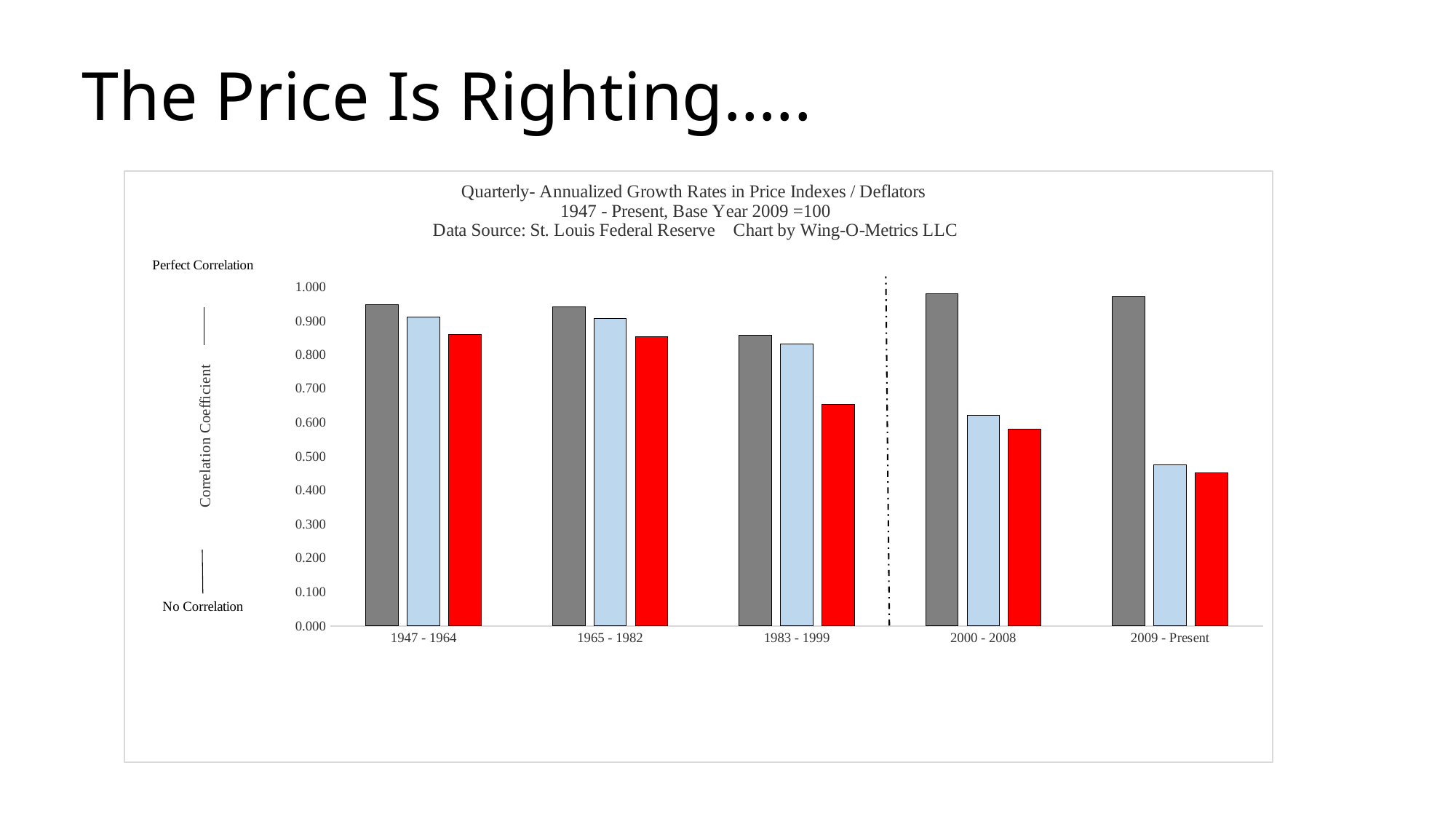
What is the label on the vertical axis? Correlation Coefficient Do the red bars generally rise or fall from 1947 - 1964 to 2009 - Present? fall According to the chart subtitle, what is the data source? St. Louis Federal Reserve In which period is the red bar lowest? 2009 - Present Is the value of the light blue bar for 2009 - Present greater or less than 0.600? less For 2009 - Present, which is larger: the gray bar or the red bar? the gray bar In which period is the light blue bar lowest? 2009 - Present Is the value of the gray bar for 2000 - 2008 greater or less than 0.900? greater What kind of chart is shown on the slide? bar chart Is the value of the red bar for 2009 - Present greater or less than 0.500? less How many time periods are shown along the x axis? 5